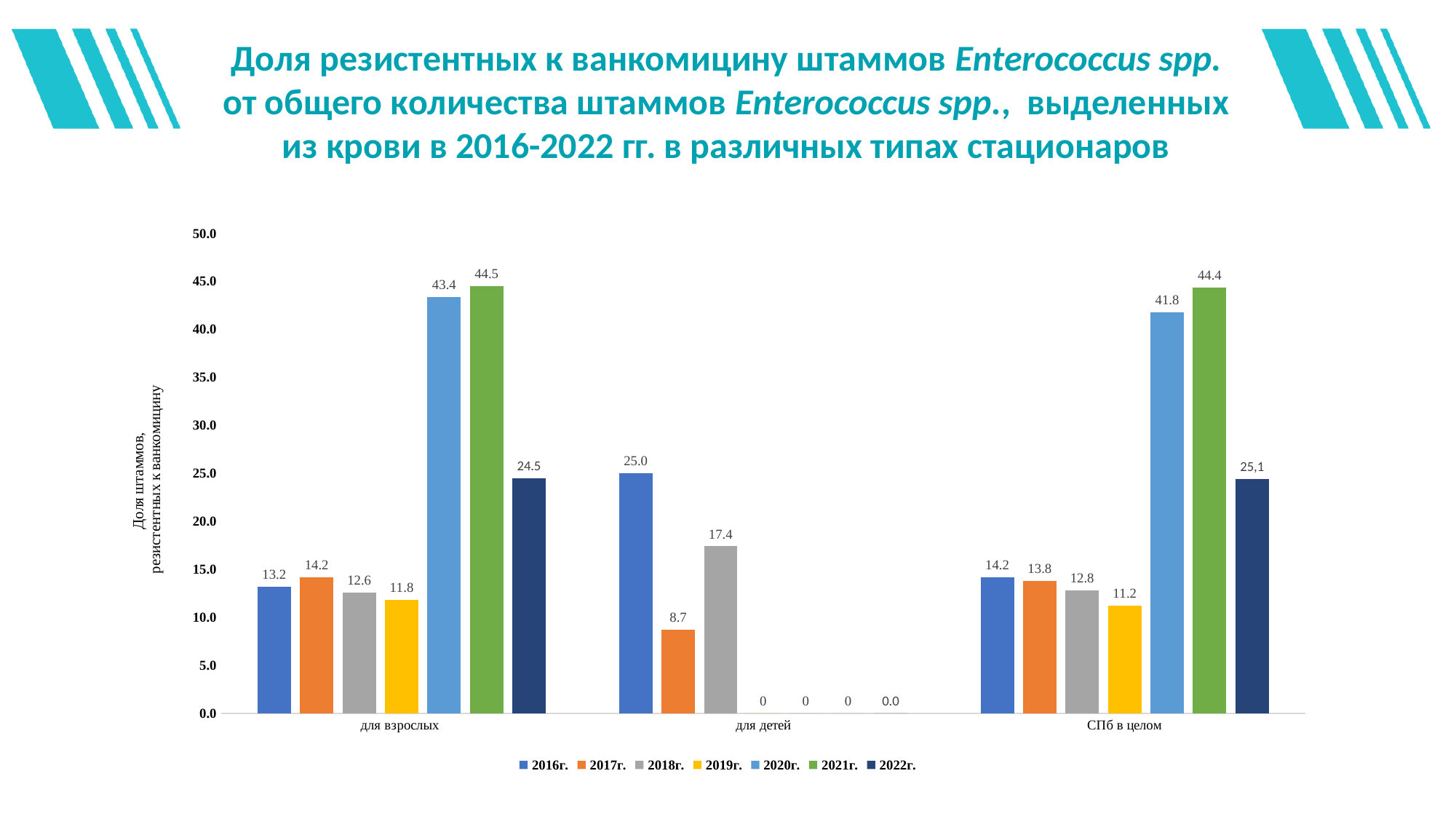
What is the difference between the 2021г. and 2020г. values in the "СПб в целом" category? 2.6 Which year has the highest value in the "для взрослых" category? 2021г. How many series does the legend list? 7 What is the value for 2017г. in the "для детей" category? 8.7 What is the value for 2022г. in the "СПб в целом" category? 25,1 Which year has the lowest value in the "СПб в целом" category? 2019г. What is the value for 2020г. in the "для взрослых" category? 43.4 What kind of chart is shown on the slide? Bar chart What is the value for 2019г. in the "для взрослых" category? 11.8 Which is larger in the "для детей" category: the 2016г. value or the 2018г. value? 2016г. What is the label of the vertical axis? Доля штаммов, резистентных к ванкомицину How many categories are shown on the x axis? 3